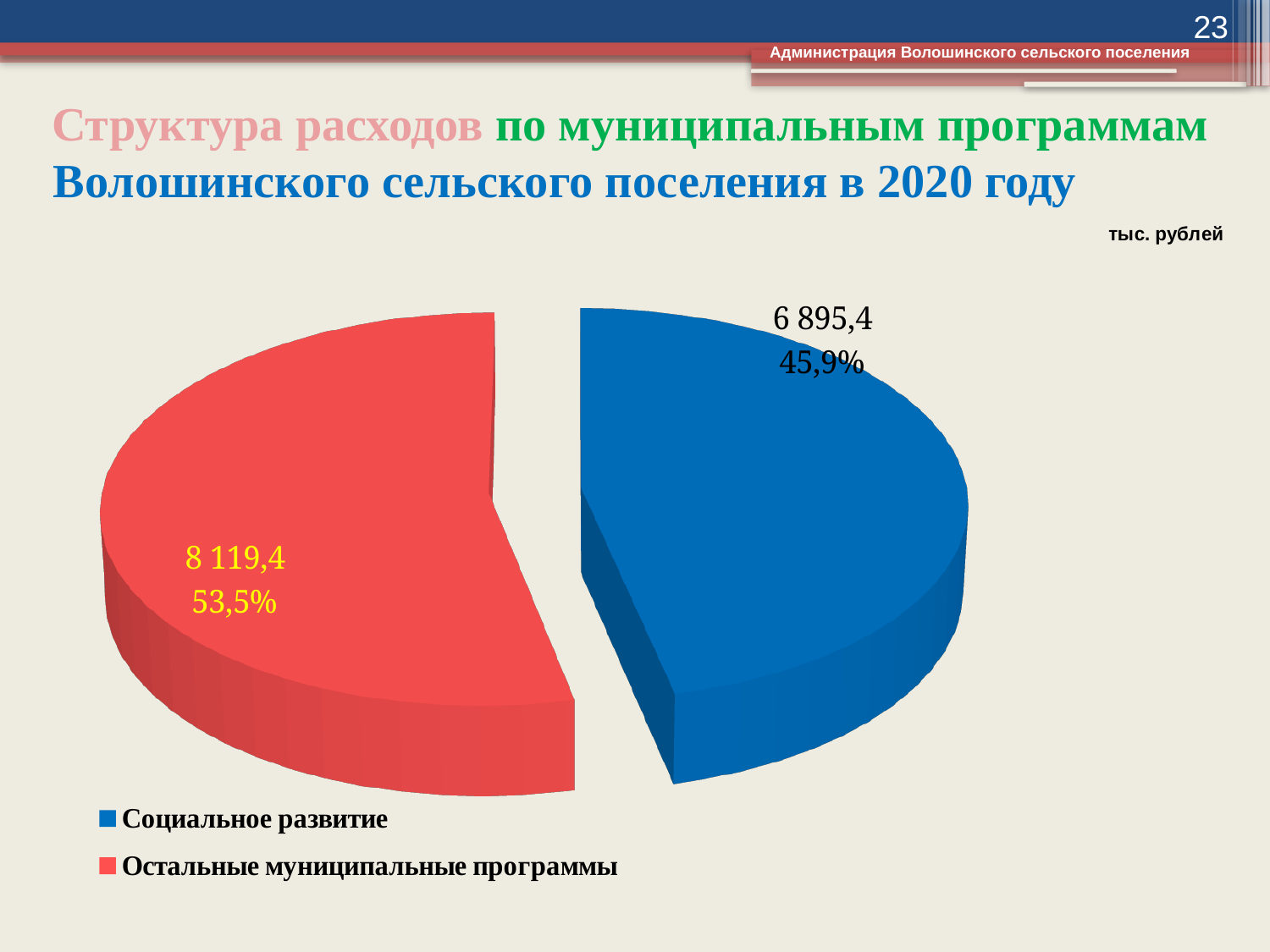
What is the value for Социальное развитие? 6 895,4 What is the value for Остальные муниципальные программы? 8 119,4 Which category has the smallest slice? Социальное развитие What share of the pie does Остальные муниципальные программы take? 53,5% What is the difference between the values for Остальные муниципальные программы and Социальное развитие? 1 224,0 Which is larger, Социальное развитие or Остальные муниципальные программы? Остальные муниципальные программы What colour is the slice for Социальное развитие? Blue How many slices does the pie chart have? 2 How many entries does the legend list? 2 What share of the pie does Социальное развитие take? 45,9% What kind of chart is shown on the slide? Pie chart Which category has the largest slice? Остальные муниципальные программы